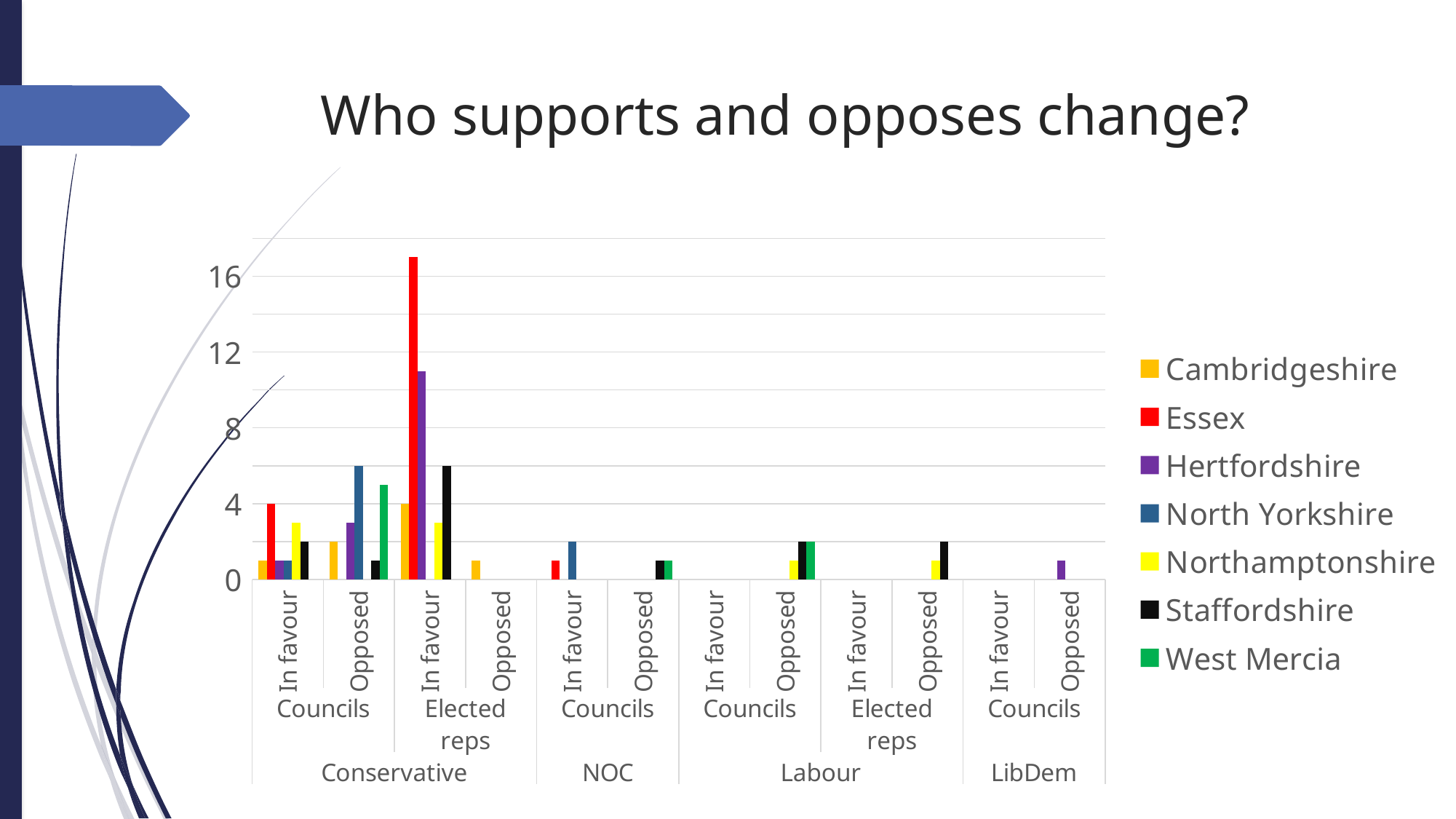
What kind of chart is shown on the slide? bar chart How many party groups are labelled along the x axis? 4 Is the value for Hertfordshire under Conservative Elected reps In favour greater or less than 8? greater Which series has the tallest bar in the whole chart? Essex Is the value for Essex under Conservative Elected reps In favour greater or less than 16? greater What is the title of the chart? Who supports and opposes change? Which is larger under Conservative Elected reps In favour: Essex or Hertfordshire? Essex Is the value for North Yorkshire under Conservative Councils Opposed greater or less than 4? greater Which is larger under Conservative Councils Opposed: North Yorkshire or Cambridgeshire? North Yorkshire How many series does the legend list? 7